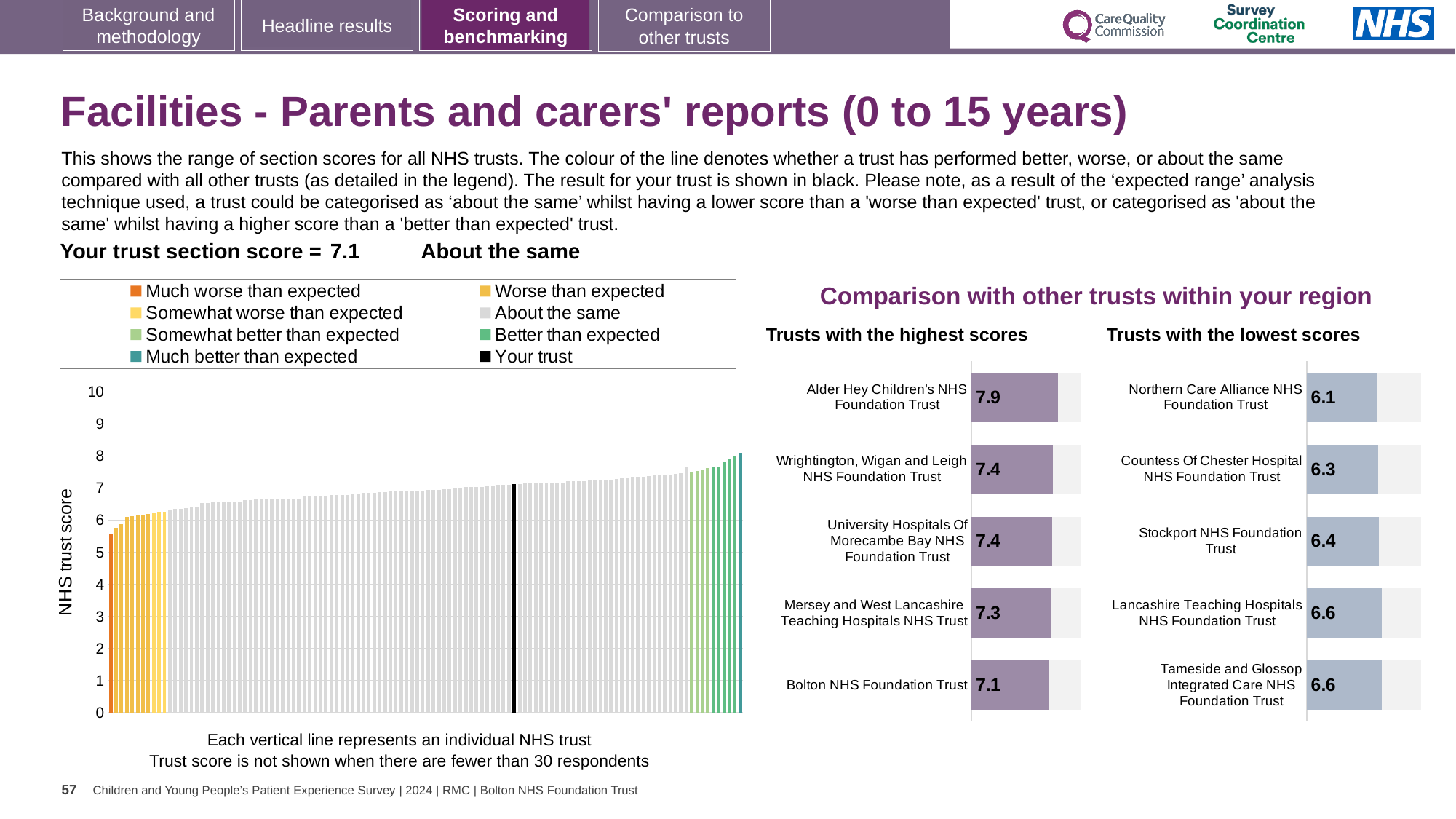
On the 'Trusts with the highest scores' chart, which trust has the lowest score shown? Bolton NHS Foundation Trust On the 'Trusts with the highest scores' chart, what is the difference between the scores of Alder Hey Children's NHS Foundation Trust and Bolton NHS Foundation Trust? 0.8 How many entries does the legend above the large chart of all NHS trusts list? 8 On the 'Trusts with the highest scores' chart, what is the score for Alder Hey Children's NHS Foundation Trust? 7.9 On the 'Trusts with the lowest scores' chart, what is the score for Stockport NHS Foundation Trust? 6.4 On the large chart of all NHS trusts on the left, what is the section score for your trust (the black line)? 7.1 What kind of chart is the large chart of all NHS trusts on the left? bar chart On the 'Trusts with the highest scores' chart, how many trusts are listed? 5 On the 'Trusts with the lowest scores' chart, what is the difference between the scores of Stockport NHS Foundation Trust and Northern Care Alliance NHS Foundation Trust? 0.3 On the large chart of all NHS trusts on the left, is the value of the lowest (leftmost) trust greater or less than 6? less On the 'Trusts with the lowest scores' chart, which is larger: the score for Countess Of Chester Hospital NHS Foundation Trust or Stockport NHS Foundation Trust? Stockport NHS Foundation Trust On the 'Trusts with the lowest scores' chart, which trust has the lowest score? Northern Care Alliance NHS Foundation Trust